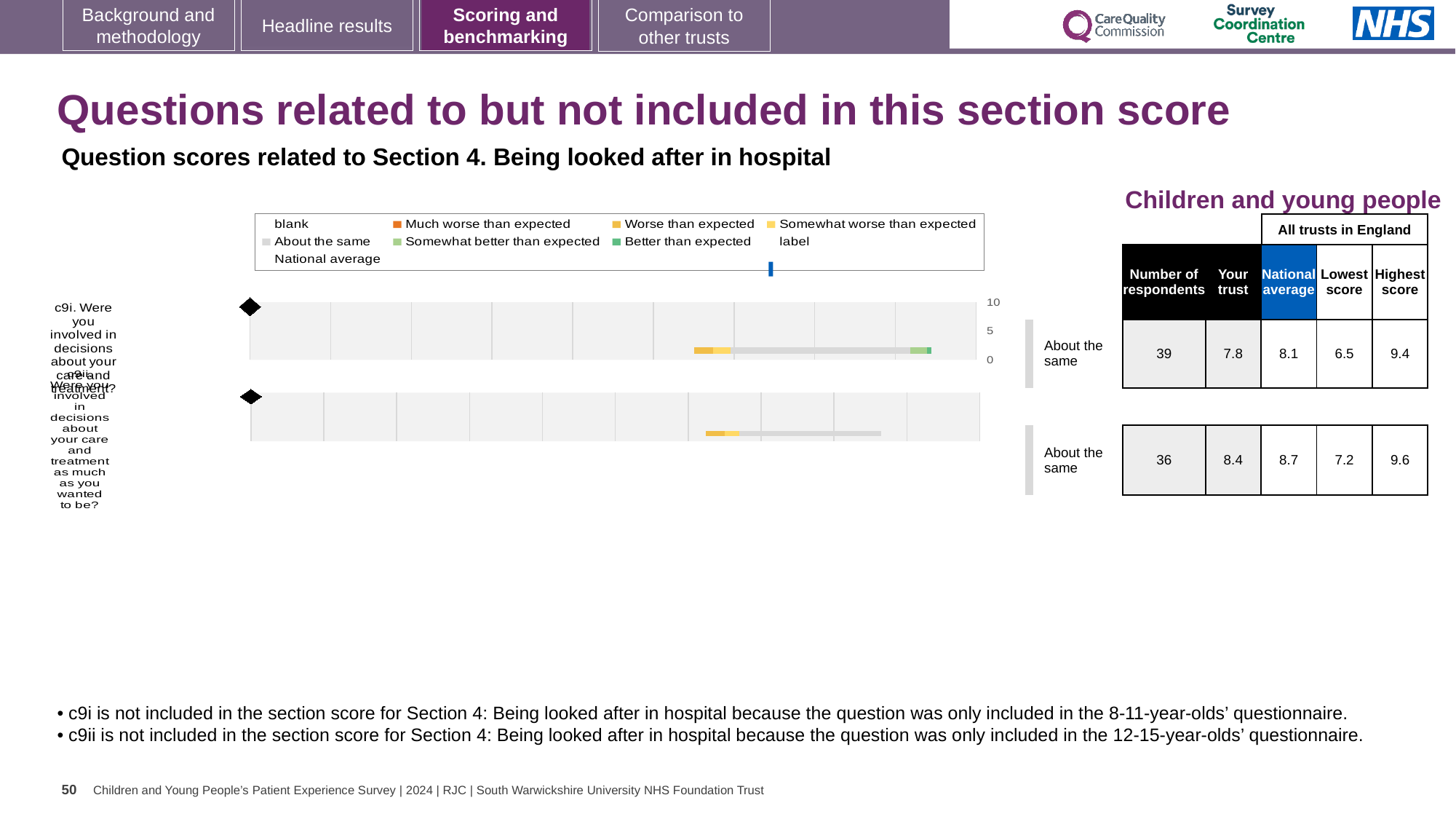
What is the highest score across all trusts in England shown for question c9ii? 9.6 How many respondents are shown for question c9ii? 36 Which question has the higher 'Your trust' score, c9i or c9ii? c9ii What is the difference between the national average and the 'Your trust' score for question c9i? 0.3 What benchmark category is shown for question c9i? About the same What is the 'Your trust' score shown for question c9ii? 8.4 In the chart legend, which colour represents 'Much worse than expected'? orange What is the national average shown for question c9i? 8.1 How many questions (chart rows) are plotted on the slide? 2 What kind of chart is used to show the question scores for c9i and c9ii? bar chart What is the 'Your trust' score shown for question c9i? 7.8 In the chart legend, which colour represents 'Better than expected'? green